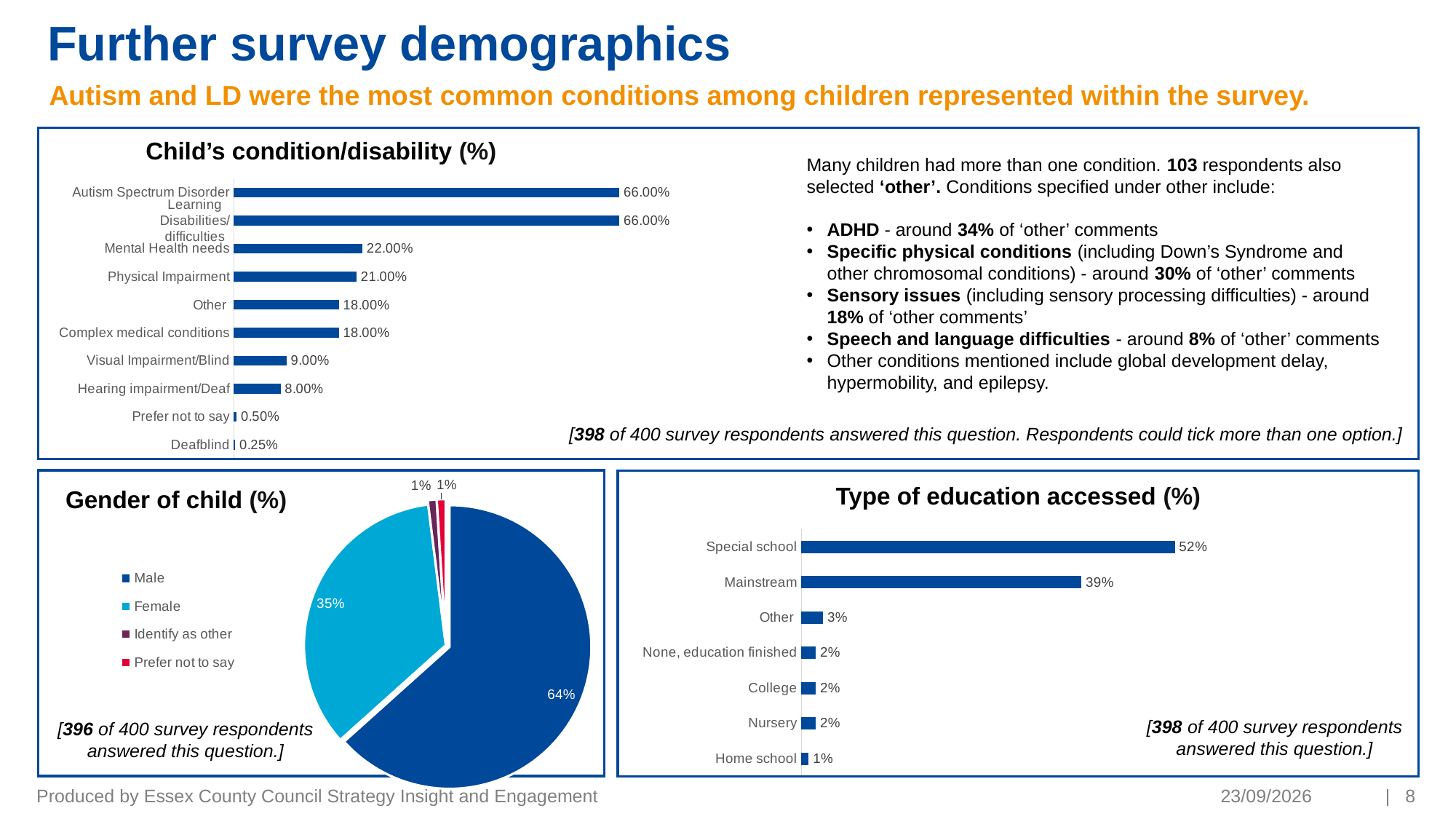
In the 'Child's condition/disability (%)' chart, what is the value for Mental Health needs? 22.00% In the 'Gender of child (%)' chart, how many entries does the legend list? 4 In the 'Child's condition/disability (%)' chart, how many categories are shown? 10 In the 'Child's condition/disability (%)' chart, which category has the lowest value? Deafblind In the 'Type of education accessed (%)' chart, which category has the highest value? Special school What kind of chart is 'Gender of child (%)'? Pie chart What kind of chart is 'Type of education accessed (%)'? Bar chart In the 'Gender of child (%)' chart, what share of the pie is Female? 35% In the 'Type of education accessed (%)' chart, what is the difference between Special school and Mainstream? 13% In the 'Child's condition/disability (%)' chart, what is the difference between Physical Impairment and Hearing impairment/Deaf? 13.00% In the 'Child's condition/disability (%)' chart, which is larger: Visual Impairment/Blind or Hearing impairment/Deaf? Visual Impairment/Blind In the 'Type of education accessed (%)' chart, what is the value for Mainstream? 39%